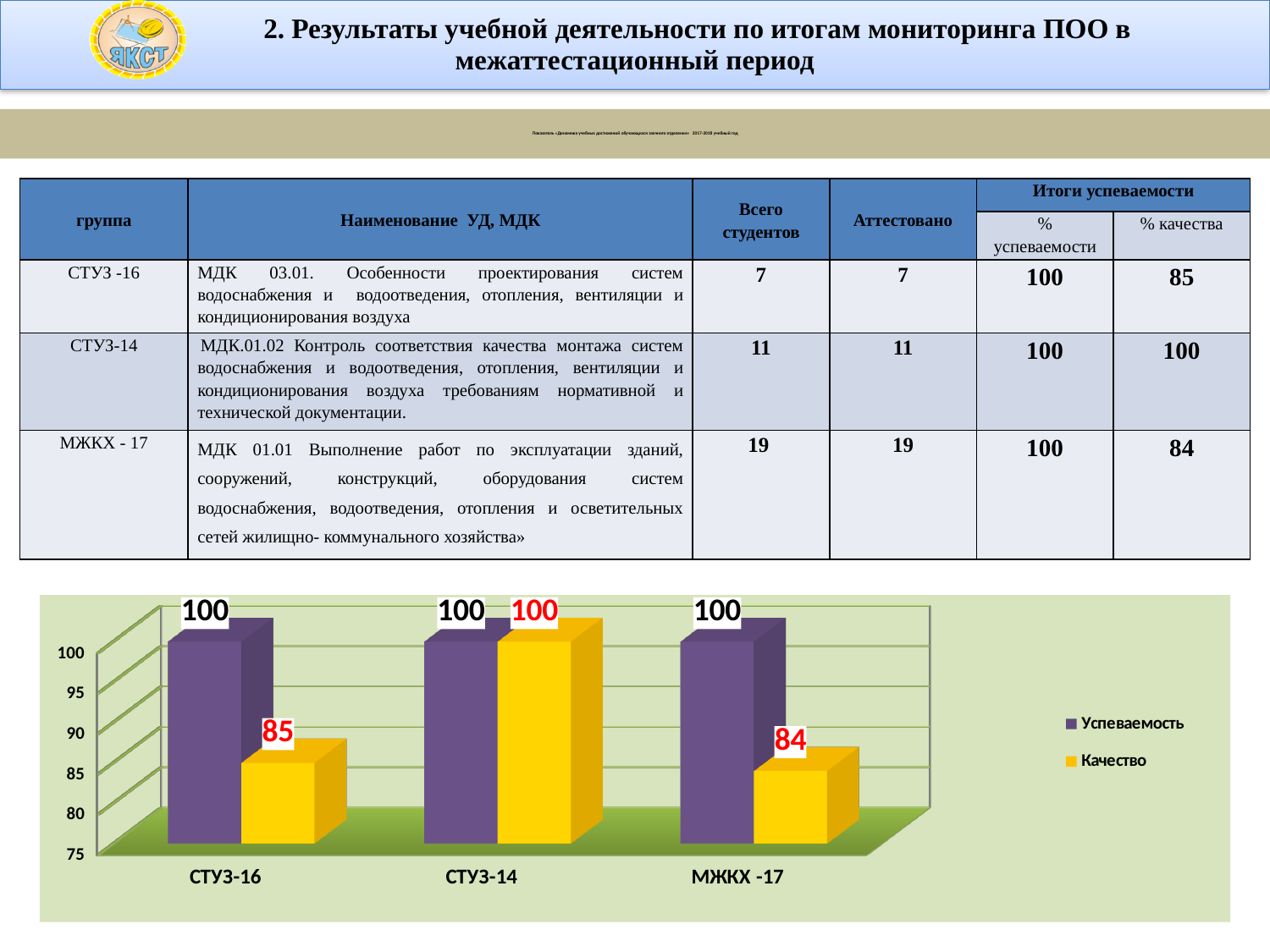
Which is larger, the Качество value for СТУЗ-14 or for МЖКХ -17? СТУЗ-14 Which category has the highest Качество value? СТУЗ-14 How many categories are shown on the x axis of the chart? 3 How many series does the chart legend list? 2 What type of chart is shown on the slide? bar chart What is the difference between the Качество values for СТУЗ-16 and МЖКХ -17? 1 What is the value of Качество for СТУЗ-14? 100 What is the difference between Успеваемость and Качество for СТУЗ-16? 15 What is the value of Качество for МЖКХ -17? 84 What is the value of Успеваемость for СТУЗ-14? 100 Which category has the lowest Качество value? МЖКХ -17 What is the value of Качество for СТУЗ-16? 85